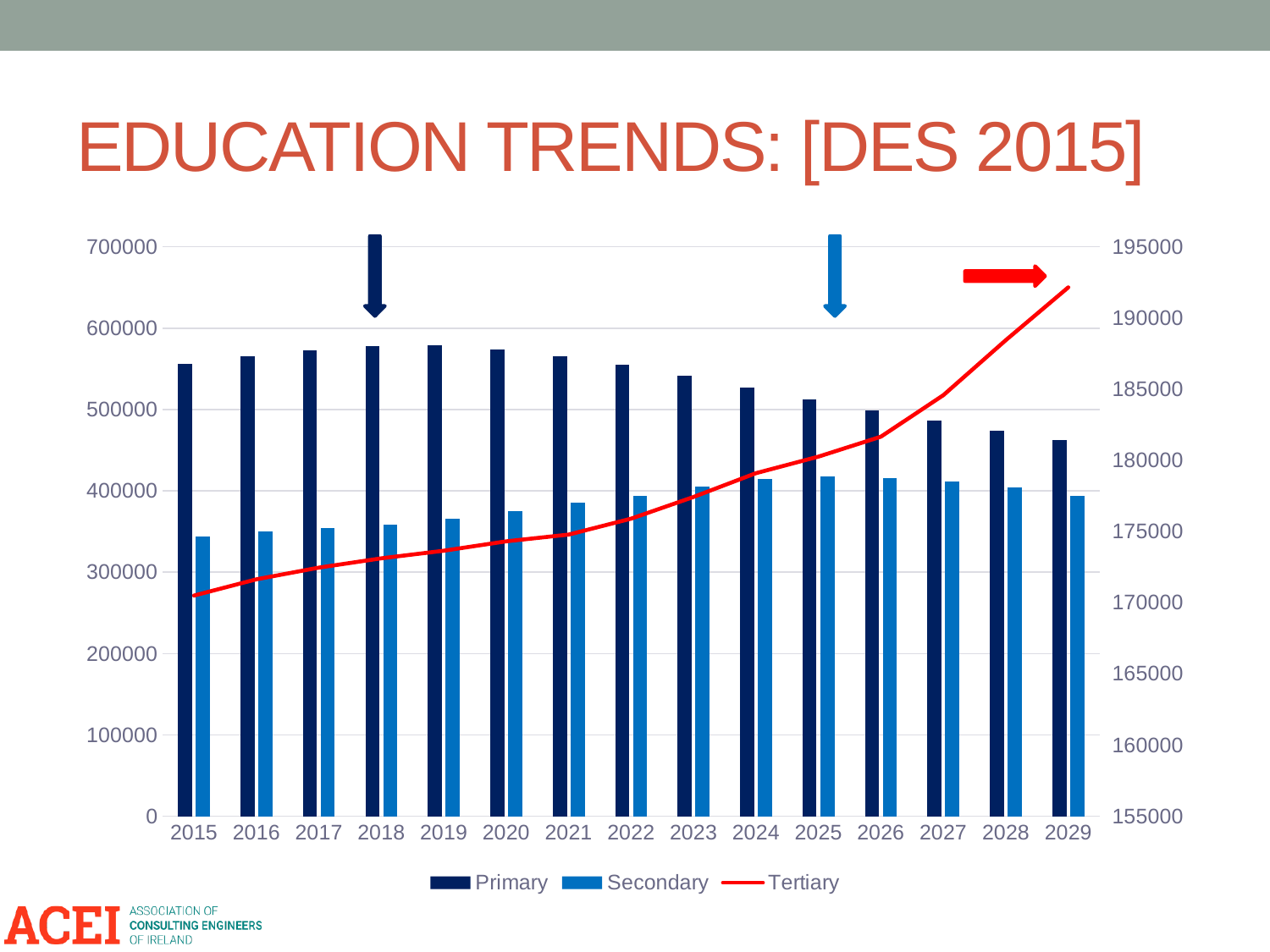
Is the Primary value for 2029 greater or less than 500000? less Does the Tertiary line rise or fall from 2015 to 2029? rise In which year is the Secondary value lowest? 2015 In which year is the Primary value lowest? 2029 How is the Tertiary series plotted, as bars or as a line? As a line How many series does the legend list? 3 Which is larger, the Primary value for 2015 or the Primary value for 2029? 2015 What colour is the Tertiary line? Red Is the Primary value for 2015 greater or less than 500000? greater Is the Secondary value for 2015 greater or less than 400000? less How many years are shown on the x axis? 15